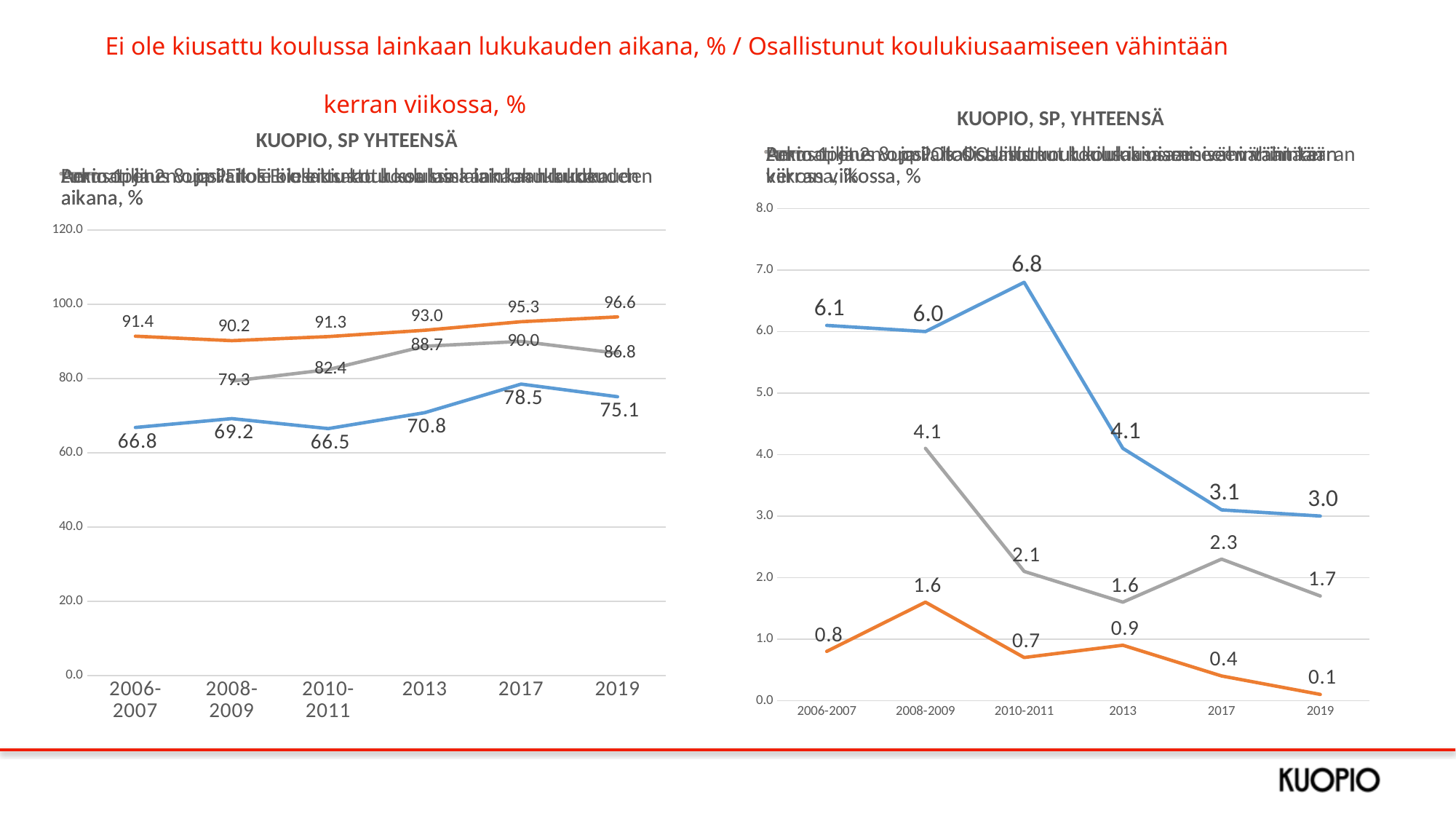
In the right chart, what is the difference between the blue line values for 2010-2011 and 2013? 2.7 In the left chart, what is the difference between the orange line and the blue line in 2019? 21.5 What type of chart is the left chart on the slide? line chart In the right chart, what is the value of the orange line for 2019? 0.1 In the left chart, what is the value of the blue line for 2019? 75.1 In the right chart, which year has the lowest value on the gray line? 2013 In the right chart, which is larger in 2017: the gray line or the orange line? gray line In the left chart, what is the value of the orange line for 2013? 93.0 In the left chart, in which year does the blue line reach its highest value? 2017 In the left chart, does the orange line generally rise or fall from 2010-2011 to 2019? rise In the left chart, how many categories are shown on the x axis? 6 In the right chart, what is the value of the blue line for 2010-2011? 6.8